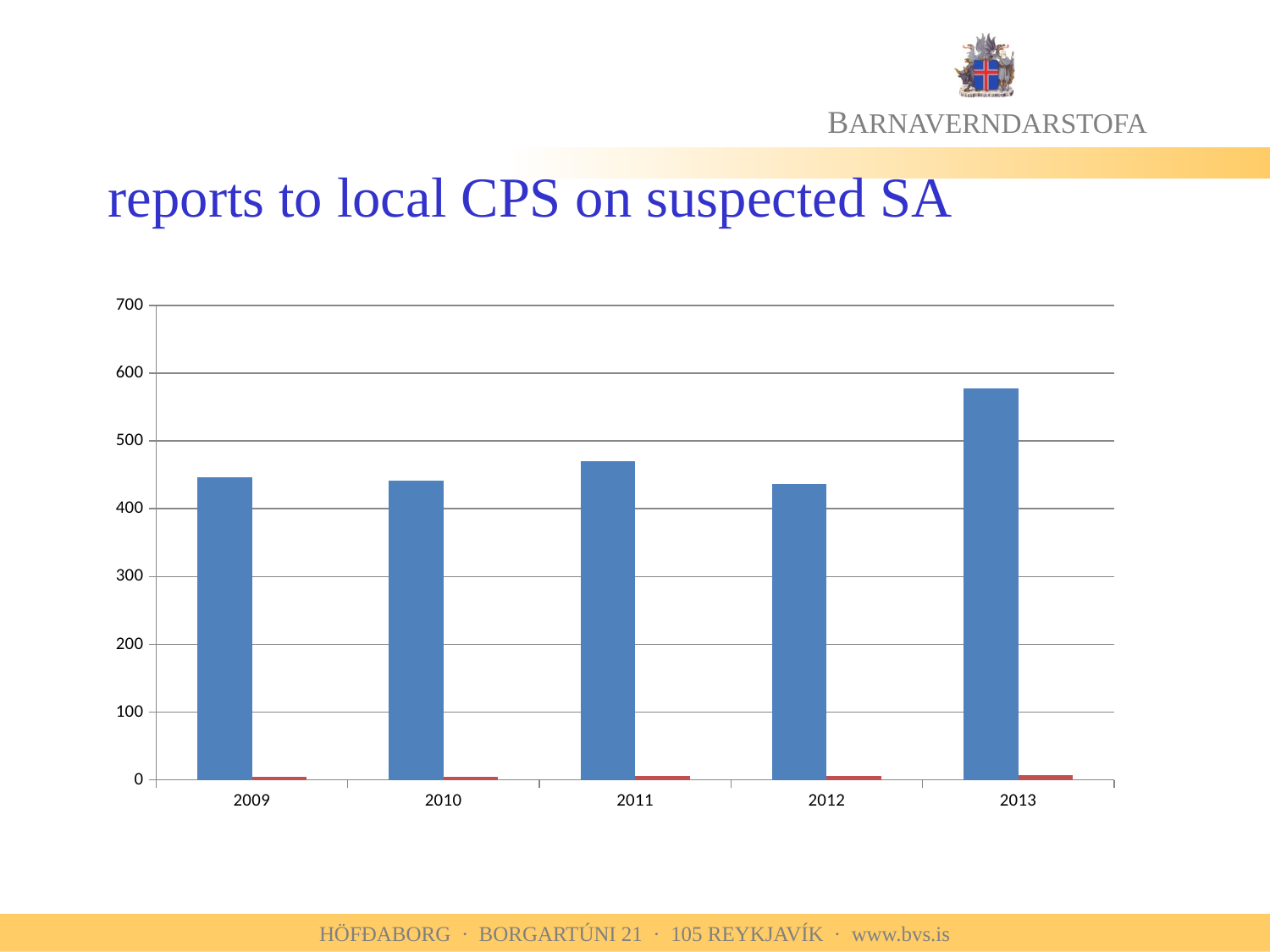
Is the blue bar for 2013 greater or less than 600? less Is the blue bar for 2011 greater or less than 400? greater Is the blue bar for 2009 greater or less than 400? greater Which year has the highest blue bar in the chart? 2013 What colour are the tall bars in the chart? blue How many years are shown on the x axis of the chart? 5 Which year has the larger blue bar, 2011 or 2012? 2011 Which year has the larger blue bar, 2012 or 2013? 2013 What kind of chart is shown on the slide? bar chart What is the title of the slide containing the chart? reports to local CPS on suspected SA